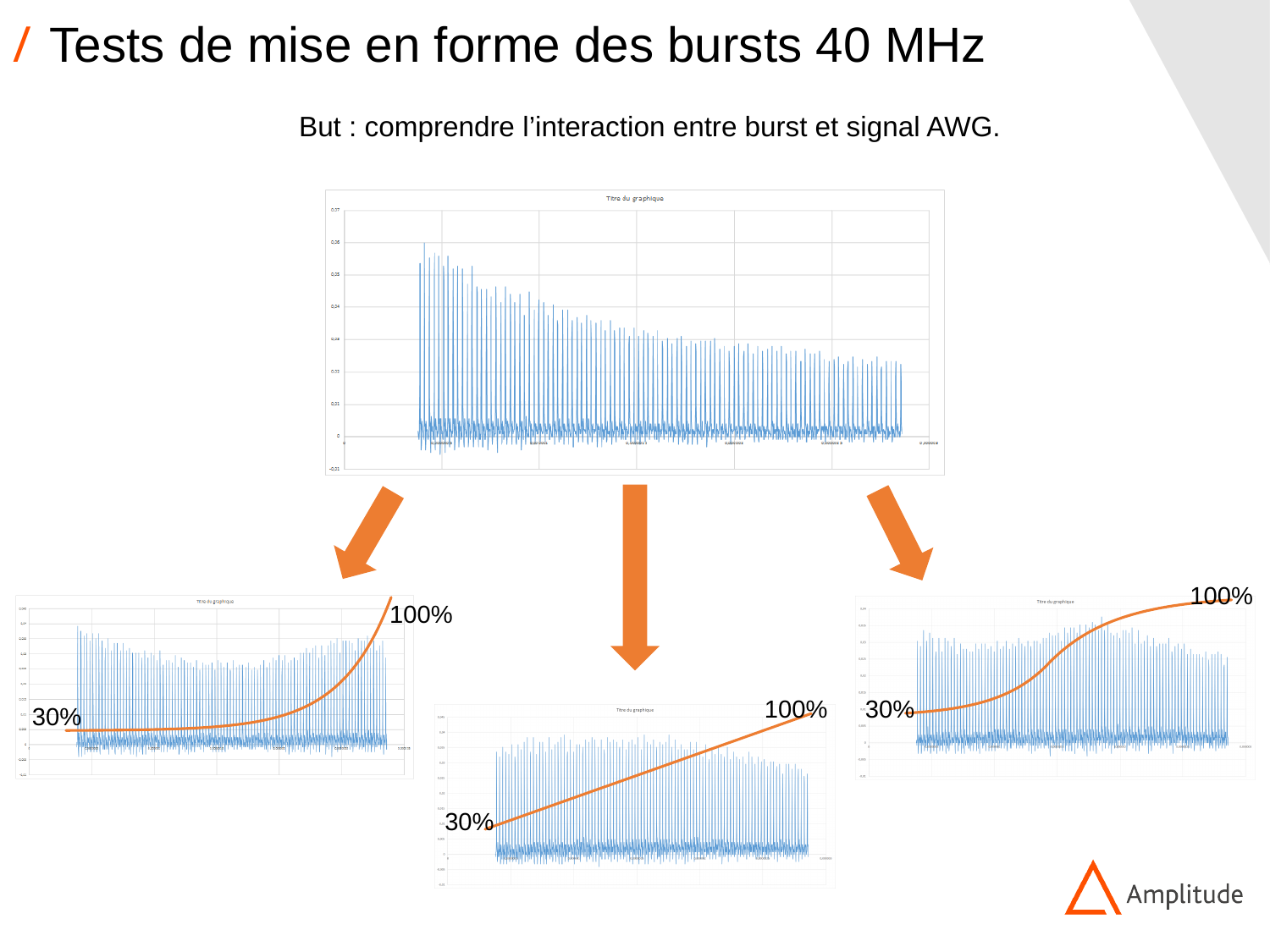
In the bottom-middle chart, which label on the orange line is larger, the one at the left end or the one at the right end? the right end (100%) How many charts are shown on the slide? 4 What kind of chart is the large chart at the top of the slide? line chart What is the title shown on the top chart? Titre du graphique In the bottom-right chart, what is the difference between the end label and the start label of the orange curve? 70% In the bottom-left chart, what percentage is labelled at the start of the orange curve? 30% In the bottom-middle chart, does the orange line rise or fall from left to right? rise What is the highest value labelled on the y axis of the top chart? 0.07 In the top chart, do the peak values rise or fall from left to right along the x axis? fall In the bottom-left chart, what percentage is labelled at the end of the orange curve? 100% In the top chart, is the highest peak greater or less than 0.05? greater In the top chart, are the peaks at the right end of the x axis greater or less than 0.03? less